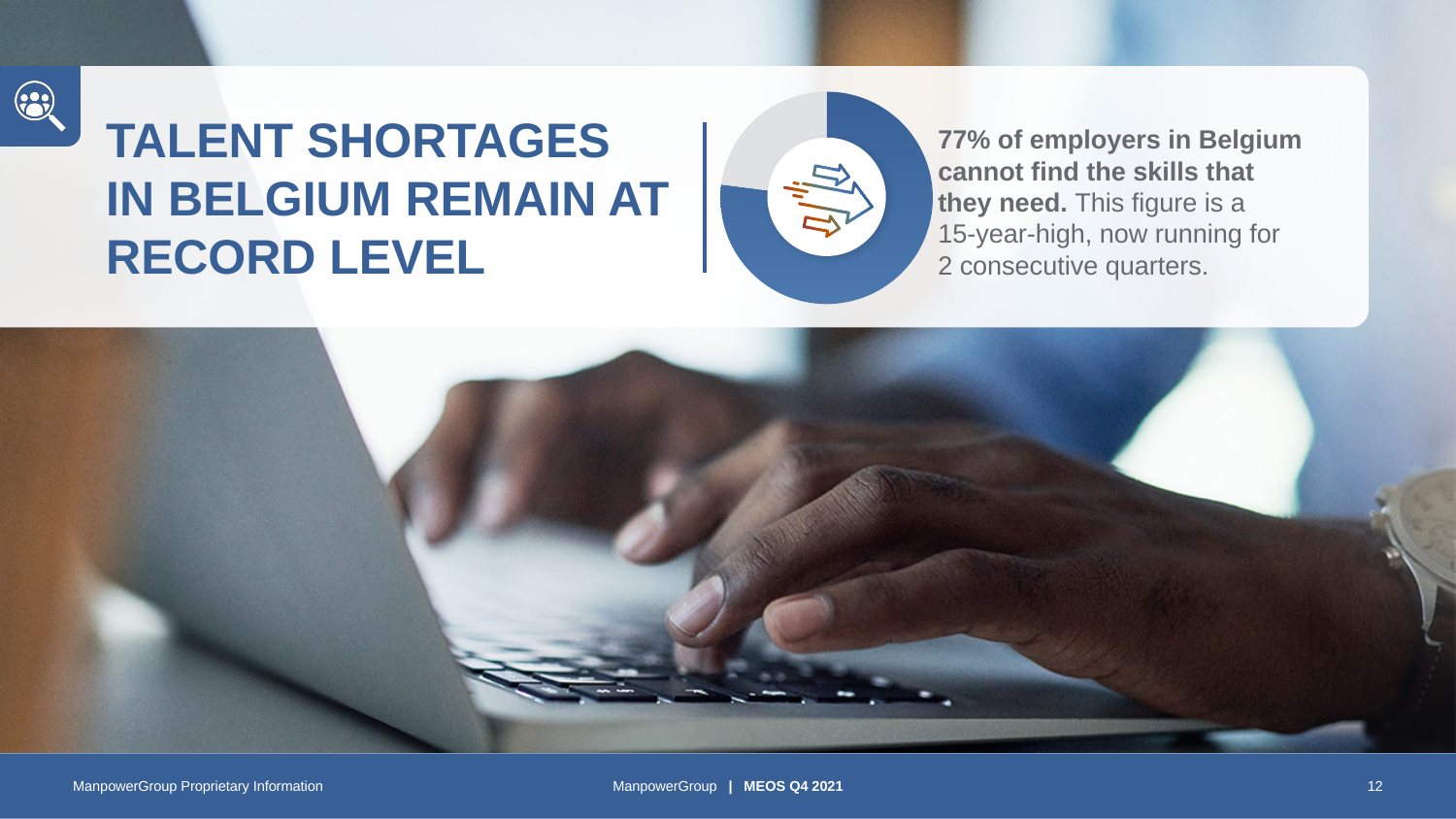
What share of employers in Belgium does the blue segment of the donut chart represent? 77% How many segments does the donut chart have? 2 What kind of chart is shown on the slide? Pie chart (donut) What colour is the larger segment of the donut chart? Blue What is the title of the slide containing the donut chart? TALENT SHORTAGES IN BELGIUM REMAIN AT RECORD LEVEL Which segment of the donut chart is larger, the blue one or the grey one? The blue one What percentage of employers in Belgium cannot find the skills they need, according to the slide? 77%